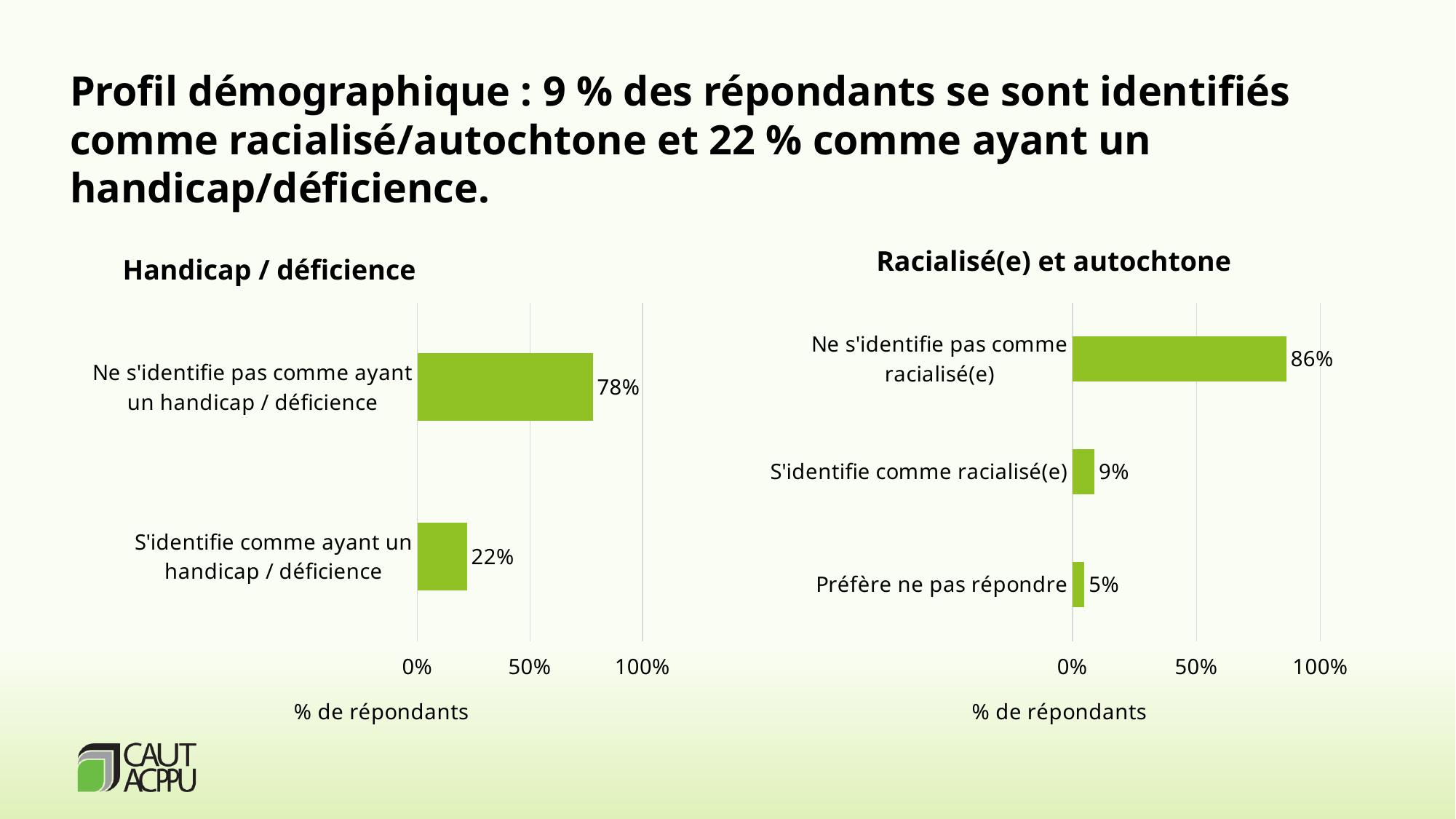
In the 'Racialisé(e) et autochtone' chart, what is the value for 'S'identifie comme racialisé(e)'? 9% In the 'Handicap / déficience' chart, what is the difference between the two categories' values? 56% In the 'Handicap / déficience' chart, what is the value for 'Ne s'identifie pas comme ayant un handicap / déficience'? 78% In the 'Handicap / déficience' chart, what is the value for 'S'identifie comme ayant un handicap / déficience'? 22% In the 'Racialisé(e) et autochtone' chart, which category has the highest value? Ne s'identifie pas comme racialisé(e) What type of chart is the 'Handicap / déficience' chart? Bar chart How many categories are shown in the 'Racialisé(e) et autochtone' chart? 3 In the 'Racialisé(e) et autochtone' chart, what is the value for 'Préfère ne pas répondre'? 5% In the 'Racialisé(e) et autochtone' chart, which category has the lowest value? Préfère ne pas répondre In the 'Racialisé(e) et autochtone' chart, which is larger: 'S'identifie comme racialisé(e)' or 'Préfère ne pas répondre'? S'identifie comme racialisé(e) In the 'Racialisé(e) et autochtone' chart, what is the difference between 'S'identifie comme racialisé(e)' and 'Préfère ne pas répondre'? 4% What is the x-axis label of the 'Racialisé(e) et autochtone' chart? % de répondants